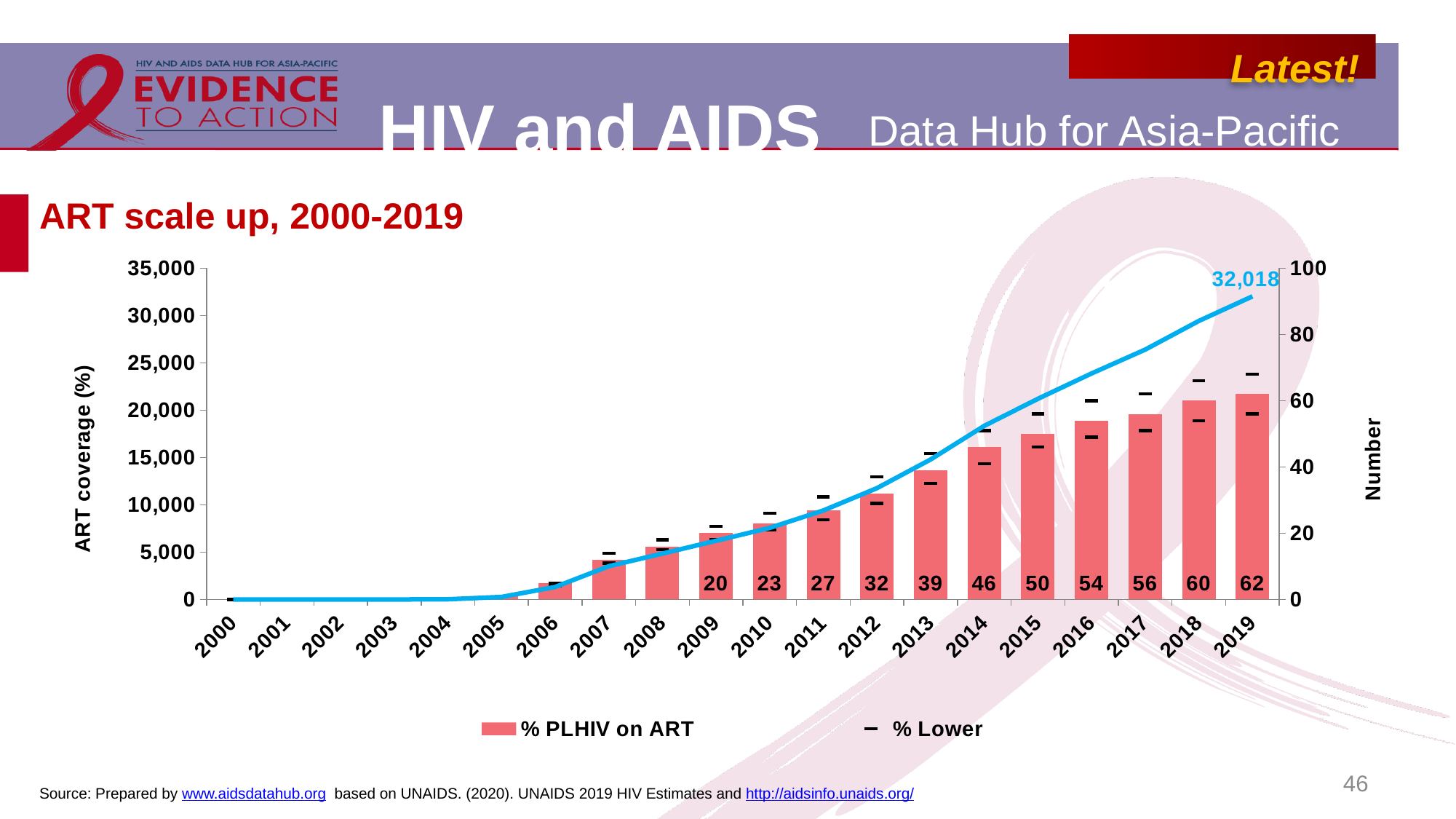
What is the % PLHIV on ART value shown for 2014? 46 By how much did the % PLHIV on ART value increase from 2009 to 2019? 42 Do the % PLHIV on ART bars rise or fall from 2009 to 2019? rise Which year has the highest % PLHIV on ART value? 2019 Is the value of the blue line in 2014 greater or less than 15,000 on the left axis? greater What is the title of the chart? ART scale up, 2000-2019 How many years are shown on the x axis? 20 What value is labelled on the blue line at 2019? 32,018 What is the difference between the % PLHIV on ART values for 2015 and 2014? 4 What is the % PLHIV on ART value shown for 2009? 20 Which year has the larger % PLHIV on ART value, 2013 or 2016? 2016 What is the % PLHIV on ART value shown for 2019? 62